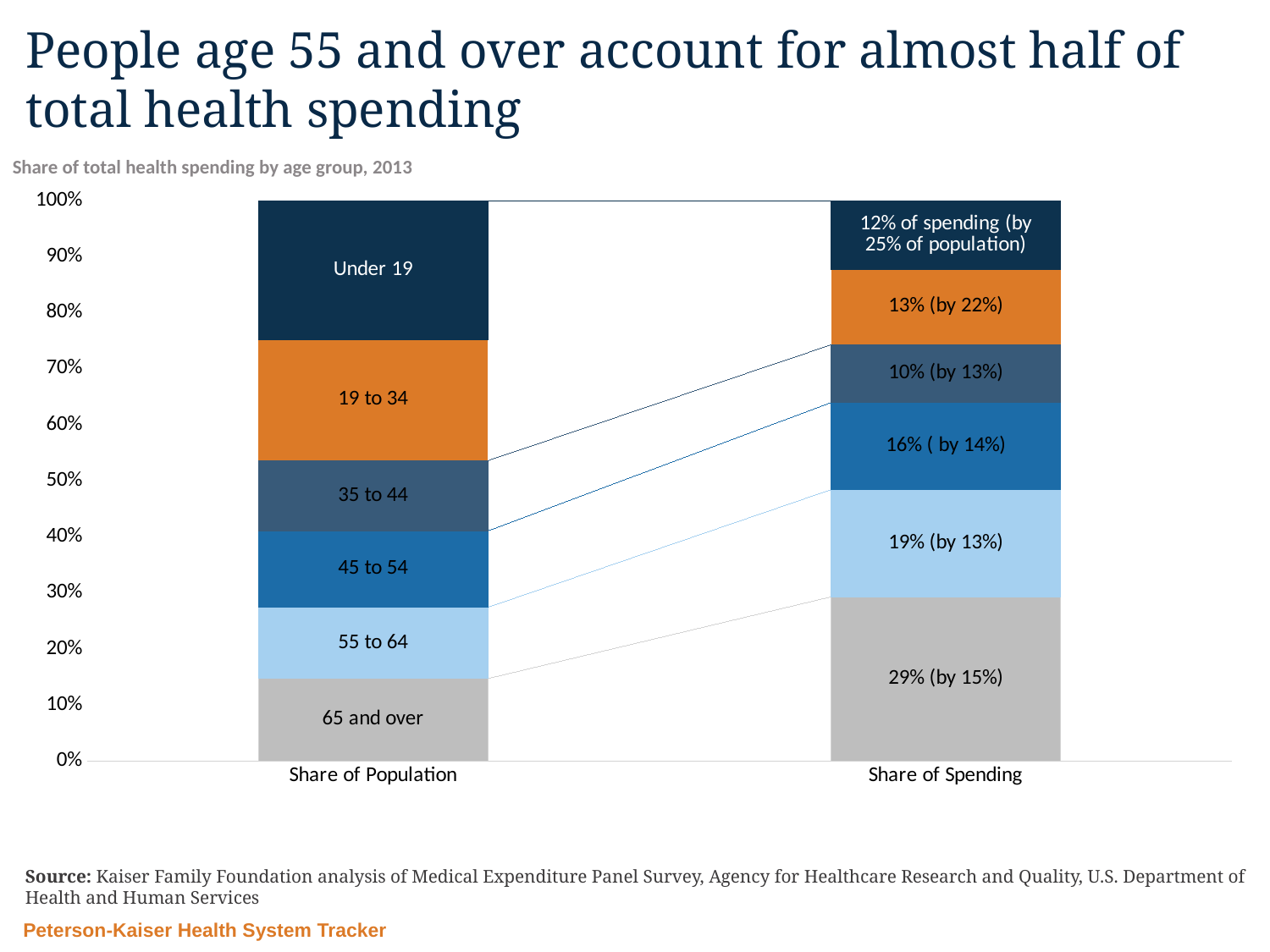
What is the combined share of spending for the 55 to 64 and 65 and over groups? 48% What type of chart is shown on the slide? Stacked bar chart What is the difference between the share of spending and the share of population for the 65 and over group? 14 percentage points How many age groups are shown in each stacked bar? 6 What are the two categories labelled on the x axis? Share of Population and Share of Spending Which age group accounts for the largest share of spending? 65 and over What share of the population is under age 19, according to the Share of Spending bar labels? 25% Which age group accounts for the smallest share of spending? 35 to 44 Which is larger: the share of spending for the 19 to 34 group or for the 45 to 54 group? 45 to 54 What is the subtitle of the chart? Share of total health spending by age group, 2013 What share of total health spending is accounted for by people age 65 and over? 29% What share of spending is attributed to the 55 to 64 age group? 19%